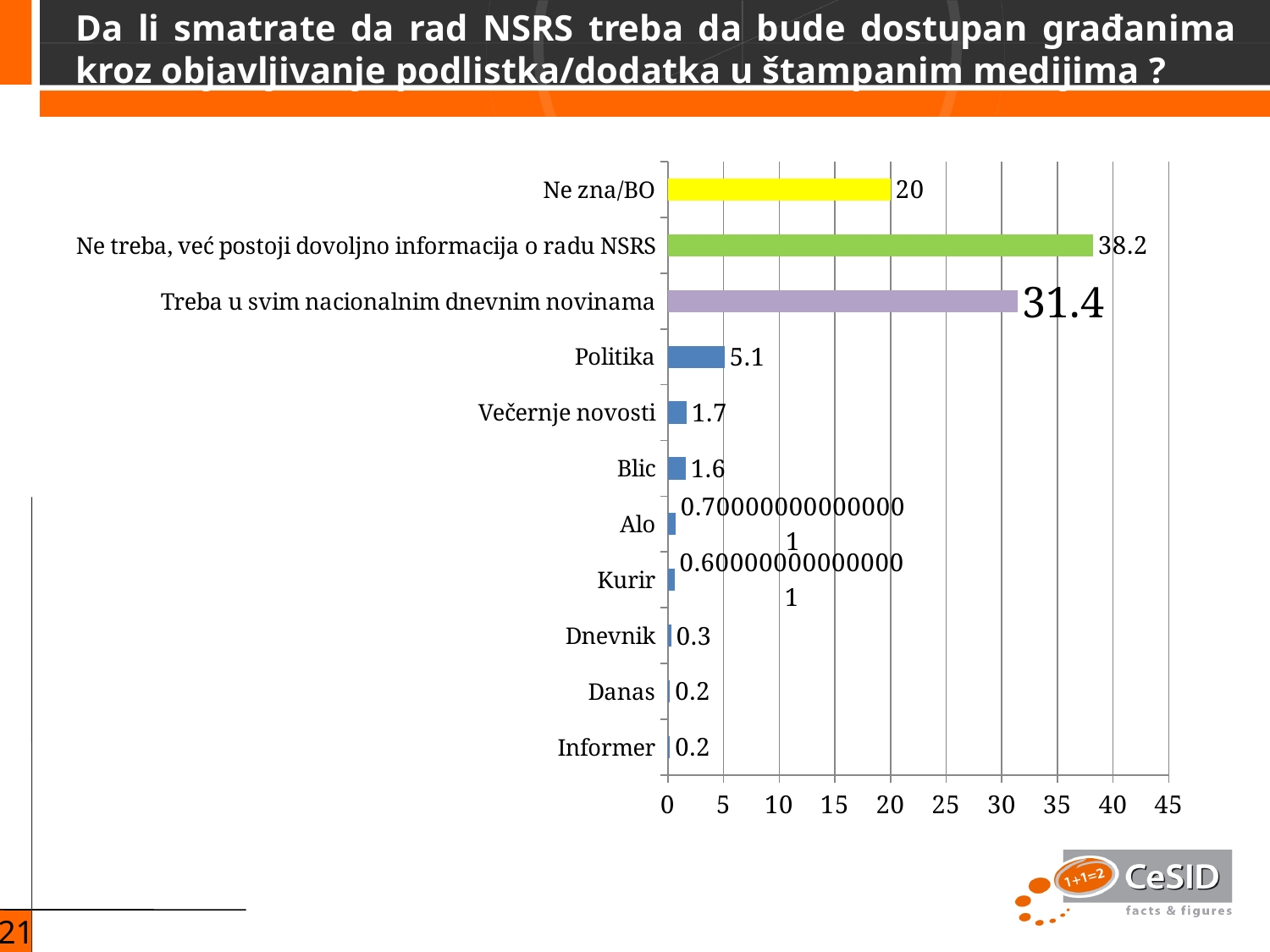
What is the value for "Politika"? 5.1 What is the maximum value shown on the horizontal axis? 45 Which category has the highest value? Ne treba, već postoji dovoljno informacija o radu NSRS Is the value for "Treba u svim nacionalnim dnevnim novinama" greater or less than 30? greater Which is larger, the value for "Politika" or the value for "Blic"? Politika What is the value for "Ne zna/BO"? 20 What is the value for "Treba u svim nacionalnim dnevnim novinama"? 31.4 How many categories are shown in the chart? 11 What is the difference between the values for "Ne treba, već postoji dovoljno informacija o radu NSRS" and "Treba u svim nacionalnim dnevnim novinama"? 6.8 What is the value for "Ne treba, već postoji dovoljno informacija o radu NSRS"? 38.2 What is the difference between the values for "Večernje novosti" and "Blic"? 0.1 What type of chart is shown on the slide? bar chart